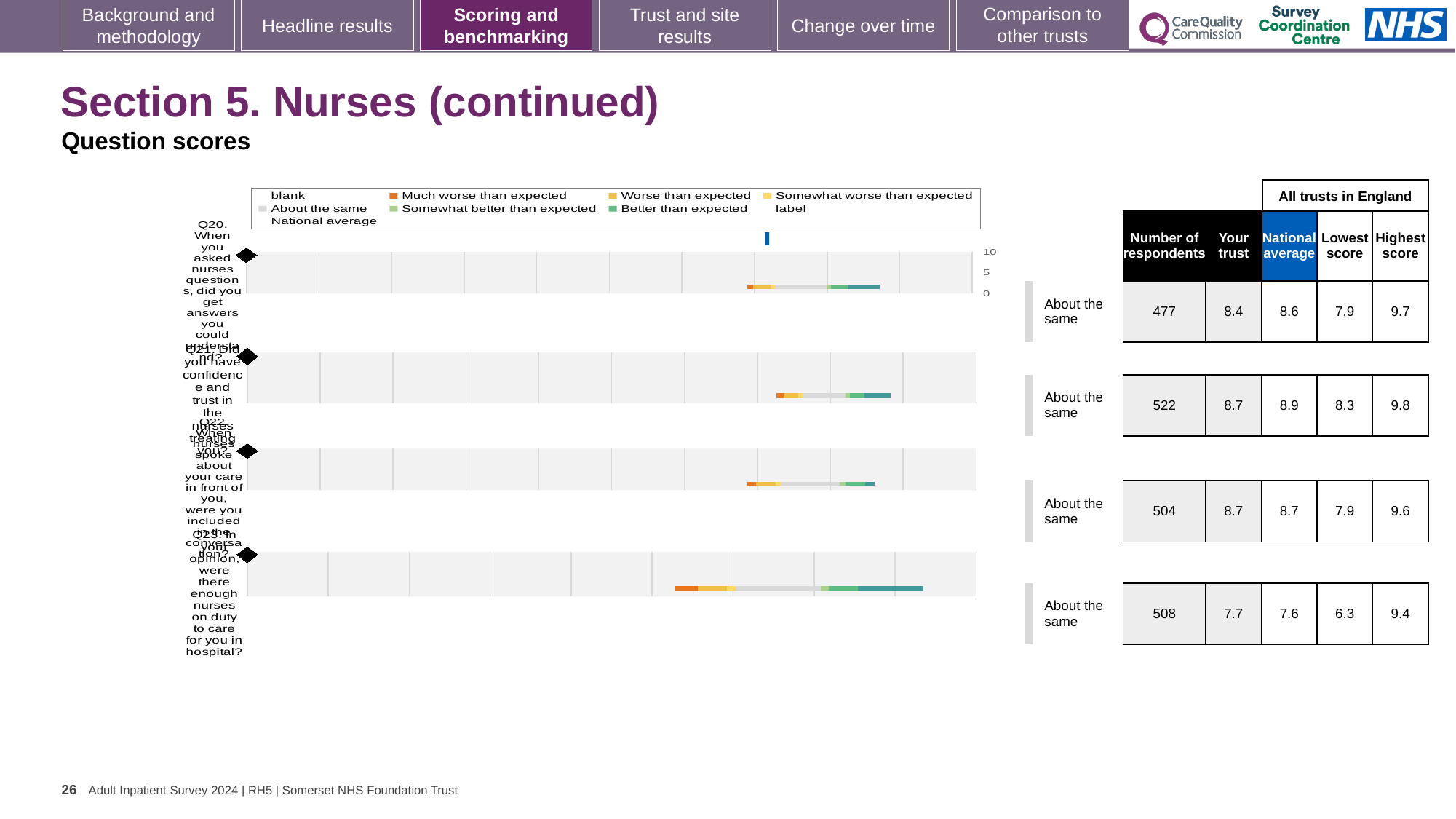
Which question has the lowest 'Your trust' score? Q23 What benchmark category is shown for Q22? About the same What is the difference between the national average and the 'Your trust' score for Q20? 0.2 For Q23, which is larger: the 'Your trust' score or the national average? Your trust What kind of chart is used to show the question scores on this slide? bar chart Which colour in the legend represents 'Much worse than expected'? orange What is the 'Your trust' score for Q20 (When you asked nurses questions, did you get answers you could understand)? 8.4 What is the lowest score among all trusts in England for Q23 (were there enough nurses on duty to care for you in hospital)? 6.3 How many respondents answered Q22 (When nurses spoke about your care in front of you, were you included in the conversation)? 504 Which question has the highest number of respondents? Q21 How many survey questions are plotted in the chart? 4 What is the national average score for Q21 (Did you have confidence and trust in the nurses treating you)? 8.9